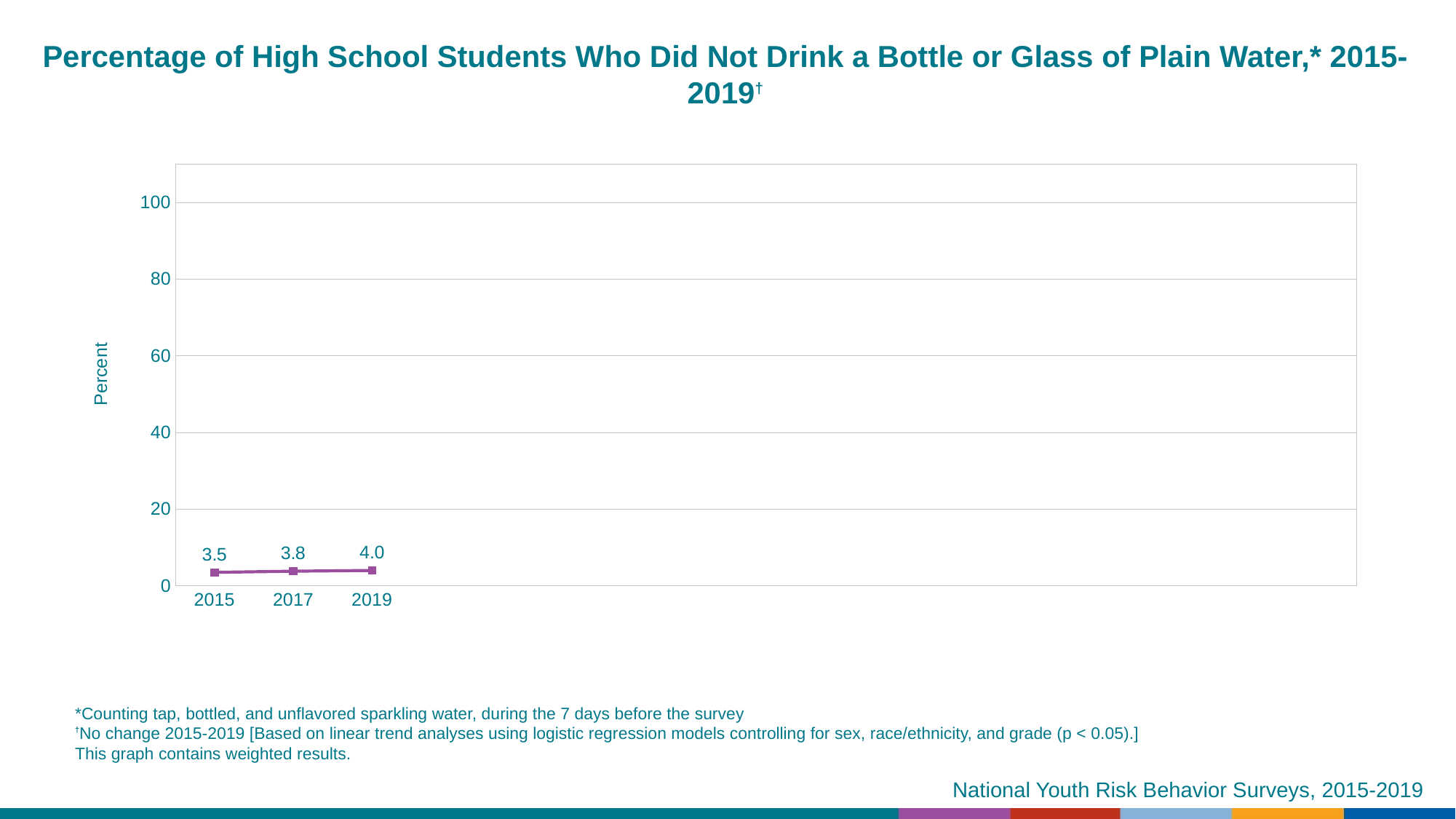
What is the value for 2019? 4.0 Which is larger, the value for 2015 or the value for 2019? 2019 Which year has the highest value? 2019 What is the difference between the values for 2019 and 2015? 0.5 What is the value for 2017? 3.8 What kind of chart is shown on the slide? line chart What is the value for 2015? 3.5 How many data points are plotted on the chart? 3 Which year has the lowest value? 2015 Is the value for 2019 greater or less than 20? less Do the values rise or fall from 2015 to 2019? rise What is the difference between the values for 2017 and 2015? 0.3